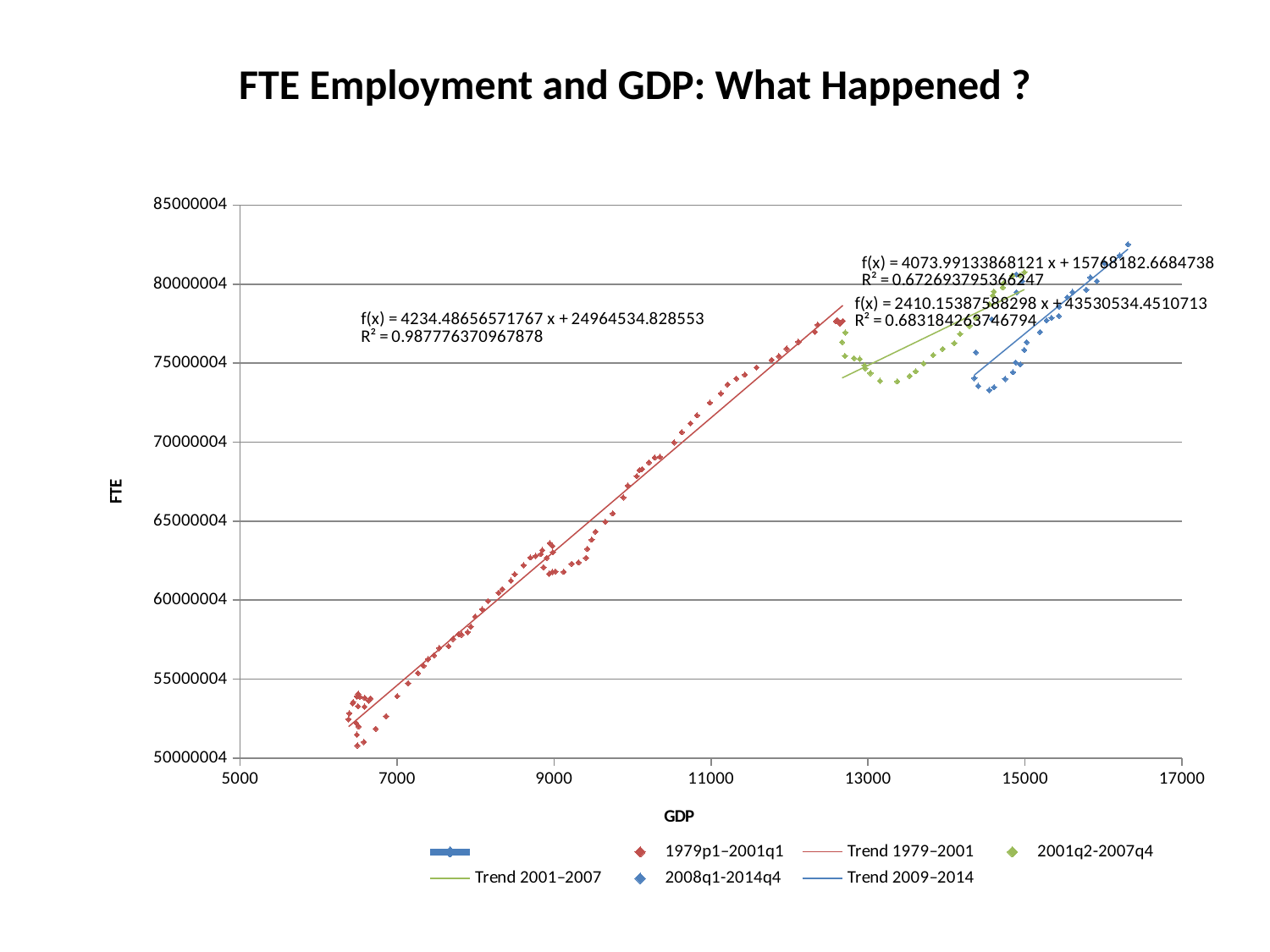
What is the R² value printed for the trend line with equation f(x) = 4234.48656571767 x + 24964534.828553? 0.987776370967878 What is the slope printed in the equation f(x) = 2410.15387588298 x + 43530534.4510713? 2410.15387588298 Are the 1979p1–2001q1 points near GDP 6500 greater or less than 55000004 FTE? less What is the highest R² value printed on the chart? 0.987776370967878 Overall, does FTE rise or fall as GDP increases along the x axis? rise What is the label of the horizontal axis? GDP Which series reaches higher FTE values: 1979p1–2001q1 or 2008q1-2014q4? 2008q1-2014q4 Is the highest 2008q1-2014q4 point, near GDP 16300, greater or less than 80000004 FTE? greater How many trend lines are listed in the legend? 3 What kind of chart is shown on the slide? scatter chart What is the lowest R² value printed on the chart? 0.672693795366247 What is the title of the chart? FTE Employment and GDP: What Happened ?